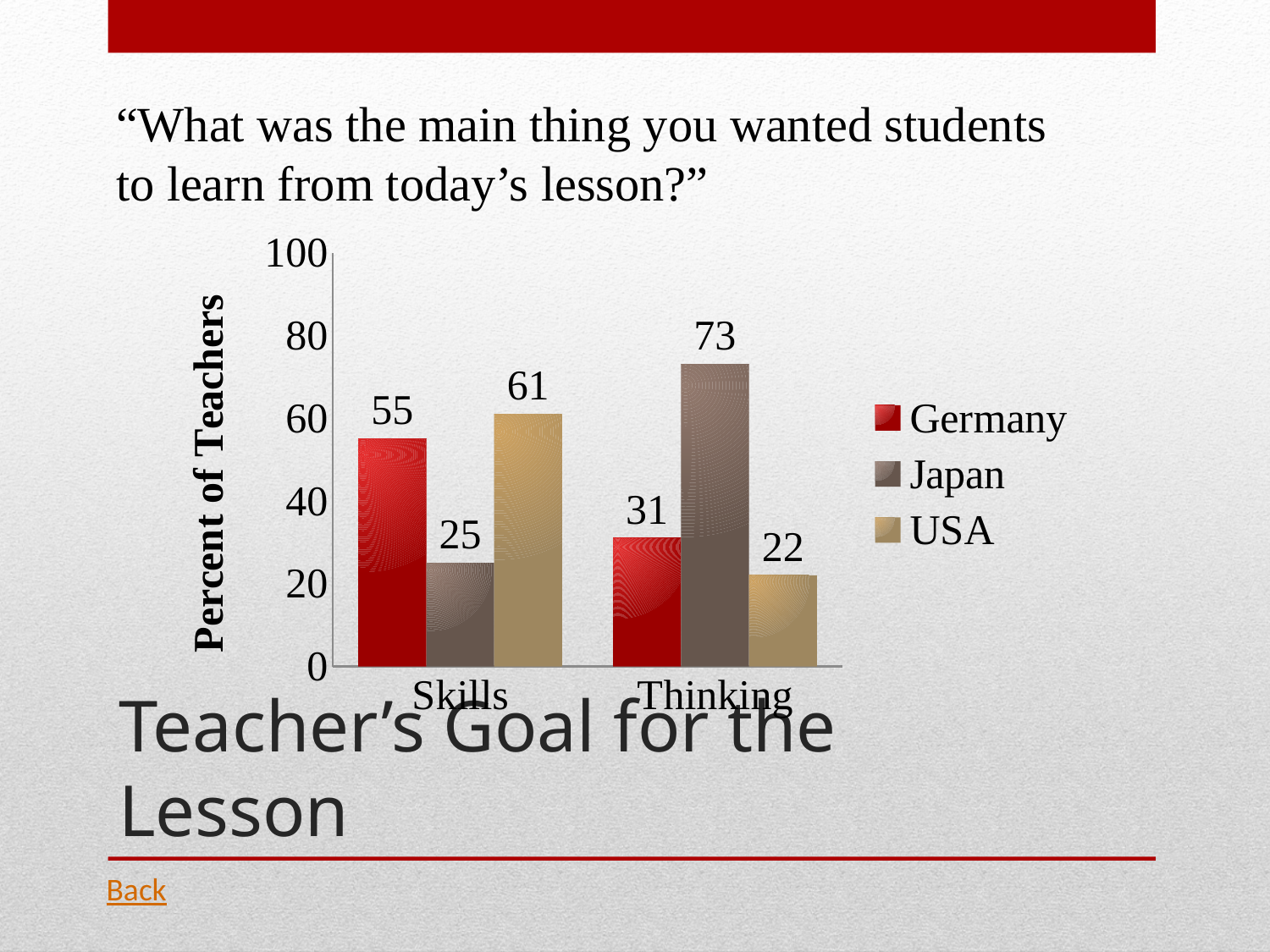
What percent of teachers in Germany chose Skills as the main goal? 55 How many categories are shown on the x axis? 2 What is the difference between Japan's Thinking value and Japan's Skills value? 48 What is the label of the vertical axis? Percent of Teachers Which country has the lowest value in the Skills category? Japan Is the value for USA in the Thinking category greater or less than 40? less What is the value for USA in the Skills category? 61 What is the value for Japan in the Thinking category? 73 What kind of chart is shown on the slide? bar chart Which country has the highest value in the Thinking category? Japan Which is larger: Germany's value for Skills or Germany's value for Thinking? Skills How many series does the legend list? 3